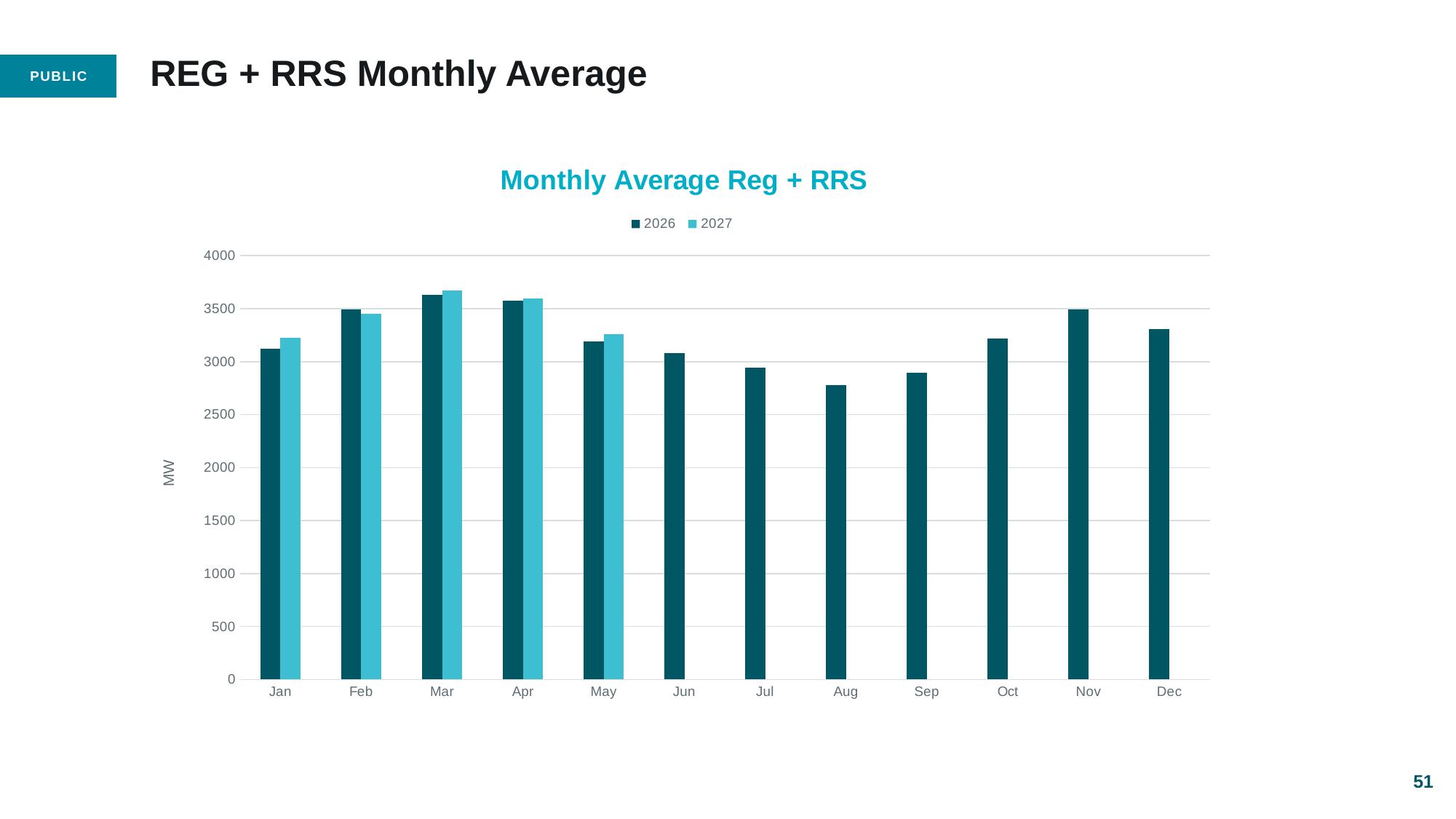
Is the value for Mar in the 2026 series greater or less than 3500? greater Is the value for Aug in the 2026 series greater or less than 3000? less What is the label on the y axis? MW Which month has the lowest value for the 2026 series? Aug Which month has the highest value for the 2027 series? Mar How many months are shown on the x axis? 12 How many series does the legend list? 2 Which month has the highest value for the 2026 series? Mar What kind of chart is shown on the slide? bar chart Do the 2026 values rise or fall from Mar to Aug? fall Is the value for Jan in the 2027 series greater or less than 3000? greater For Jan, which series has the larger value, 2026 or 2027? 2027